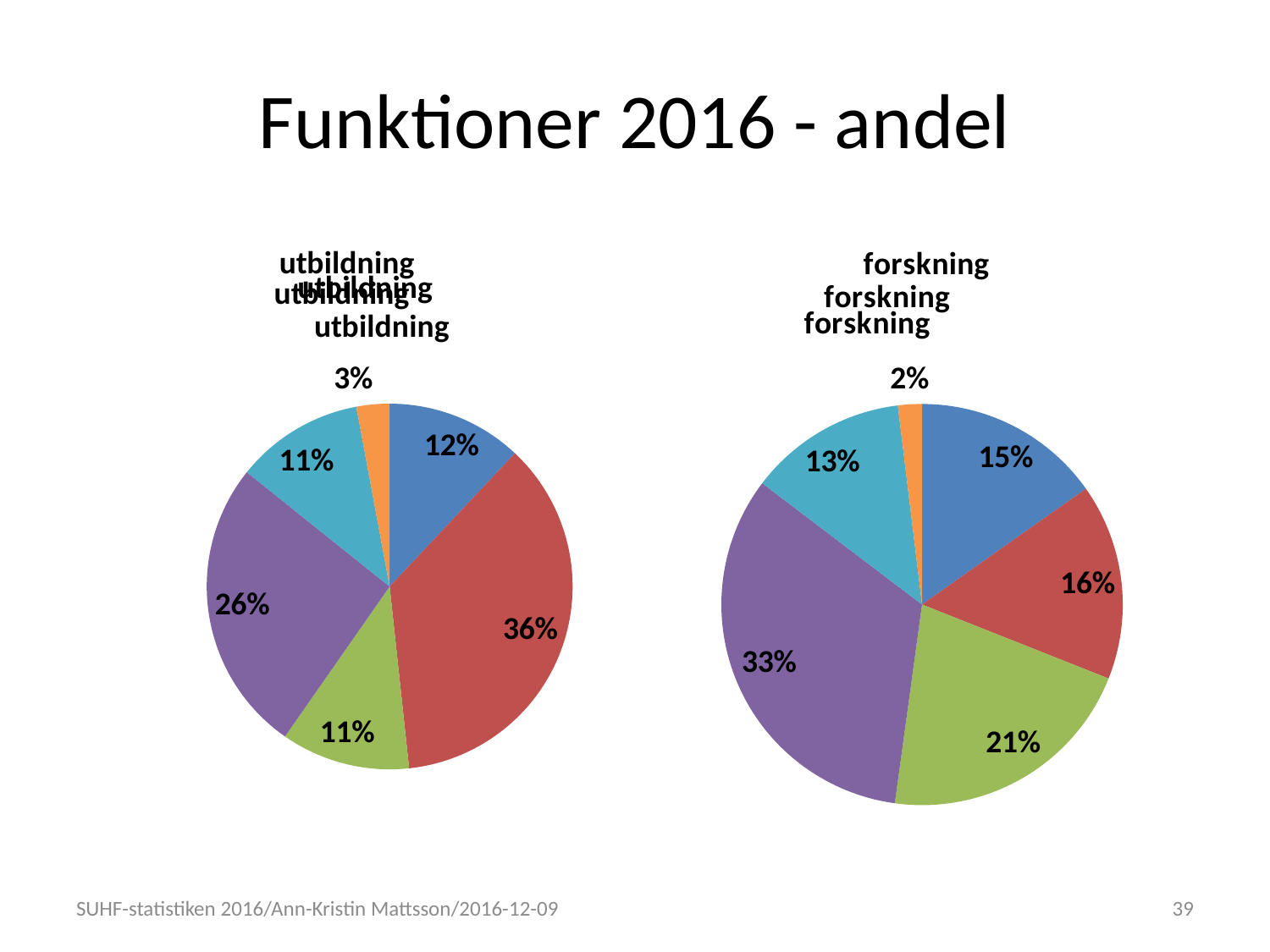
In the right pie chart (forskning), what is the share of the largest slice? 33% In the left pie chart (utbildning), what percentage does the red slice represent? 36% How many slices does the left pie chart (utbildning) have? 6 What type of chart is shown on the left side of the slide? pie chart In the right pie chart (forskning), what is the share of the smallest slice? 2% How many pie charts are on the slide? 2 In the left pie chart (utbildning), what is the share of the smallest slice? 3% In the right pie chart (forskning), what percentage does the purple slice represent? 33% What is the difference between the red slice (36%) and the blue slice (12%) in the left pie chart (utbildning)? 24% In the right pie chart (forskning), what percentage does the green slice represent? 21% Which is larger in the right pie chart (forskning): the blue slice or the green slice? the green slice In the left pie chart (utbildning), what percentage does the purple slice represent? 26%